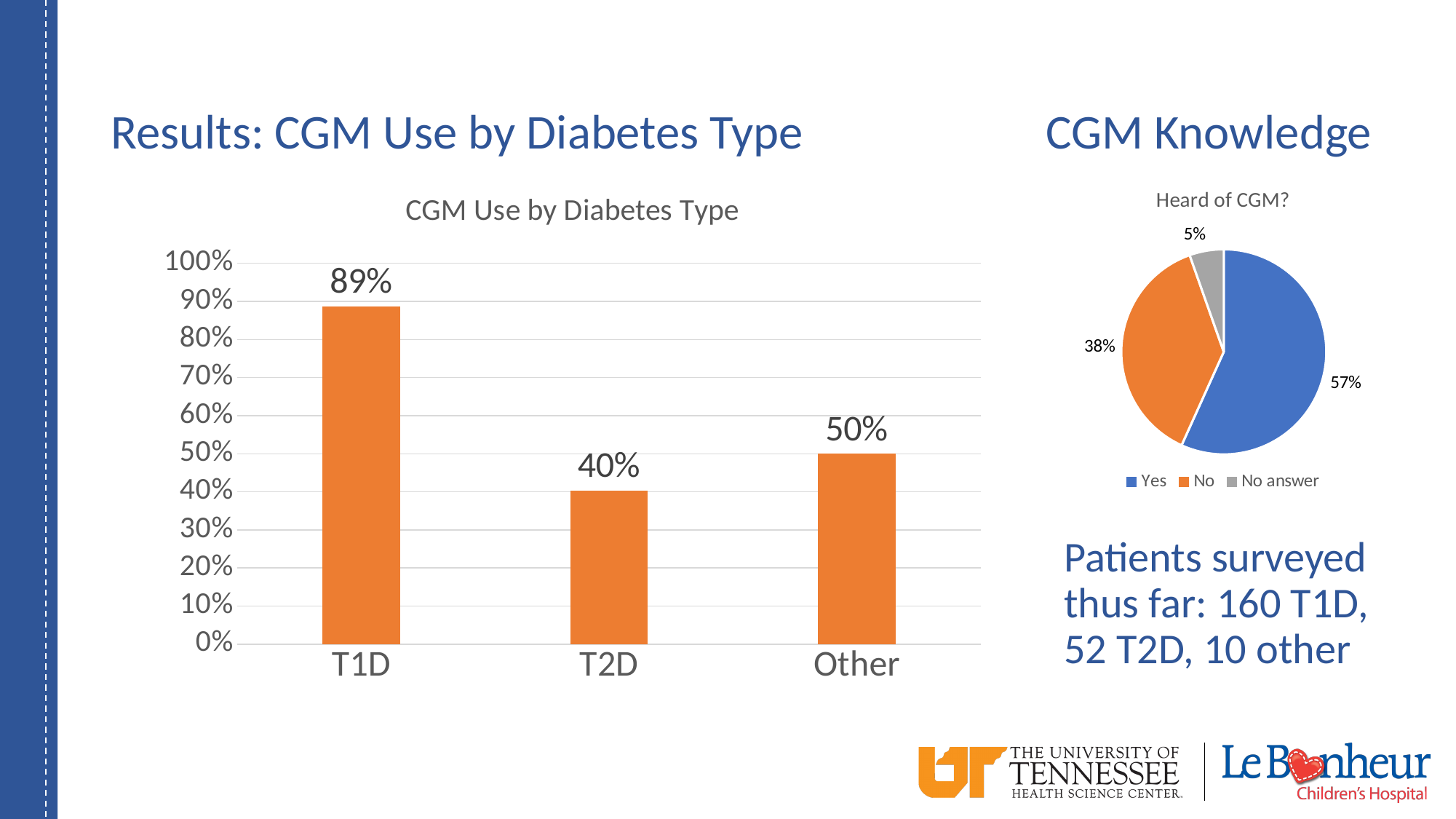
In the 'CGM Use by Diabetes Type' chart, what is the value for Other? 50% What kind of chart is the 'CGM Use by Diabetes Type' chart? Bar chart In the 'Heard of CGM?' pie chart, what is the value for 'No answer'? 5% In the 'Heard of CGM?' pie chart, what share of the pie is 'Yes'? 57% How many entries does the legend of the 'Heard of CGM?' pie chart list? 3 In the 'CGM Use by Diabetes Type' chart, which category has the lowest value? T2D In the 'CGM Use by Diabetes Type' chart, which category has the highest value? T1D How many categories are shown in the 'CGM Use by Diabetes Type' chart? 3 In the 'CGM Use by Diabetes Type' chart, which is larger, the value for Other or the value for T2D? Other In the 'CGM Use by Diabetes Type' chart, what is the value for T2D? 40% In the 'CGM Use by Diabetes Type' chart, what is the difference between the T1D and T2D values? 49% In the 'CGM Use by Diabetes Type' chart, what is the value for T1D? 89%